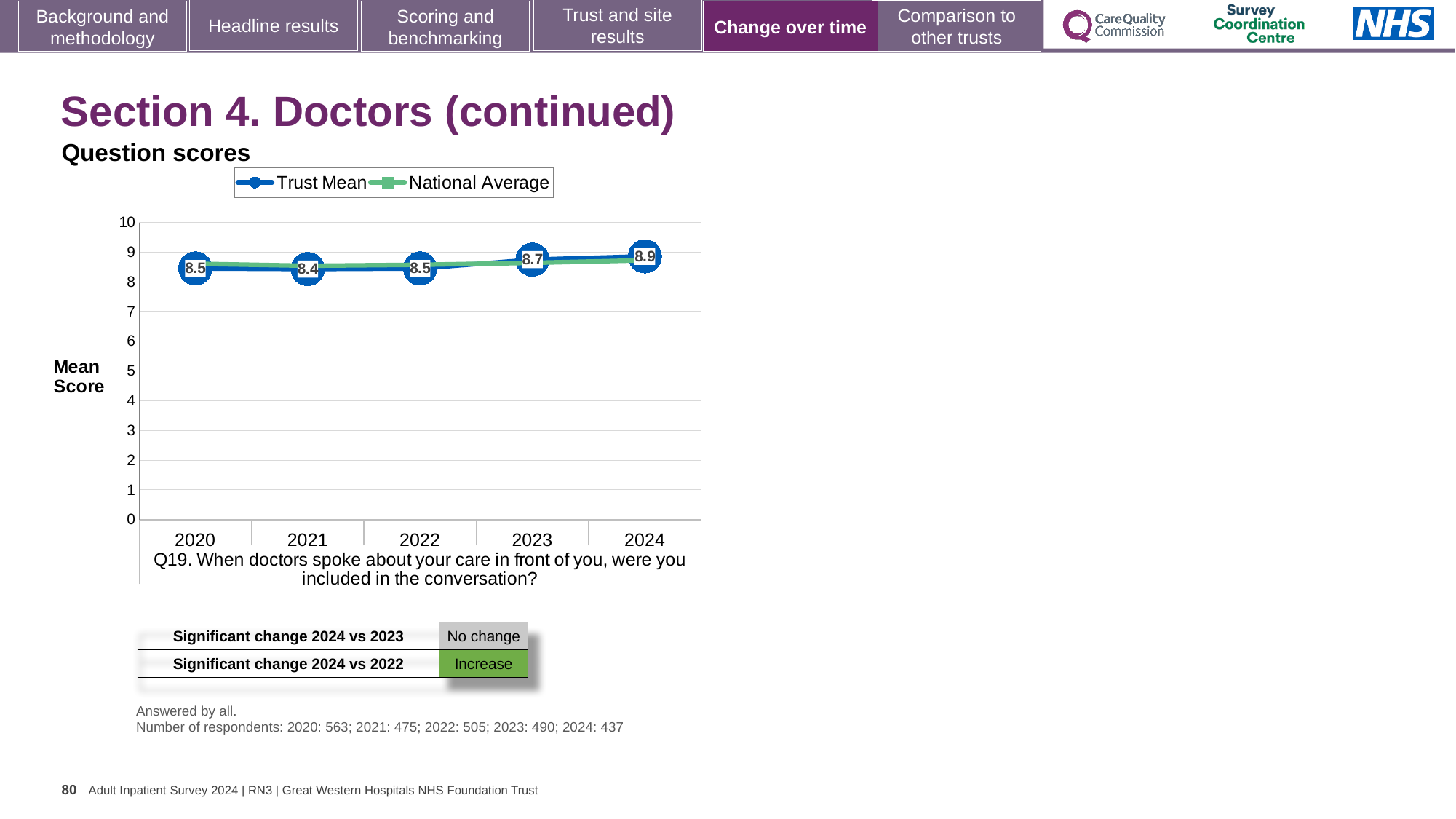
What kind of chart is shown on the slide? Line chart In which year is the Trust Mean score lowest? 2021 What is the Trust Mean score for 2024? 8.9 What is the Trust Mean score for 2021? 8.4 What is the difference between the Trust Mean score in 2024 and in 2020? 0.4 What is the Trust Mean score for 2020? 8.5 How many years are plotted on the x axis? 5 Does the Trust Mean score rise or fall between 2022 and 2024? Rise Is the National Average value for 2020 greater or less than 8? greater In which year is the Trust Mean score highest? 2024 Which year has the larger Trust Mean score, 2023 or 2021? 2023 How many series does the legend list? 2